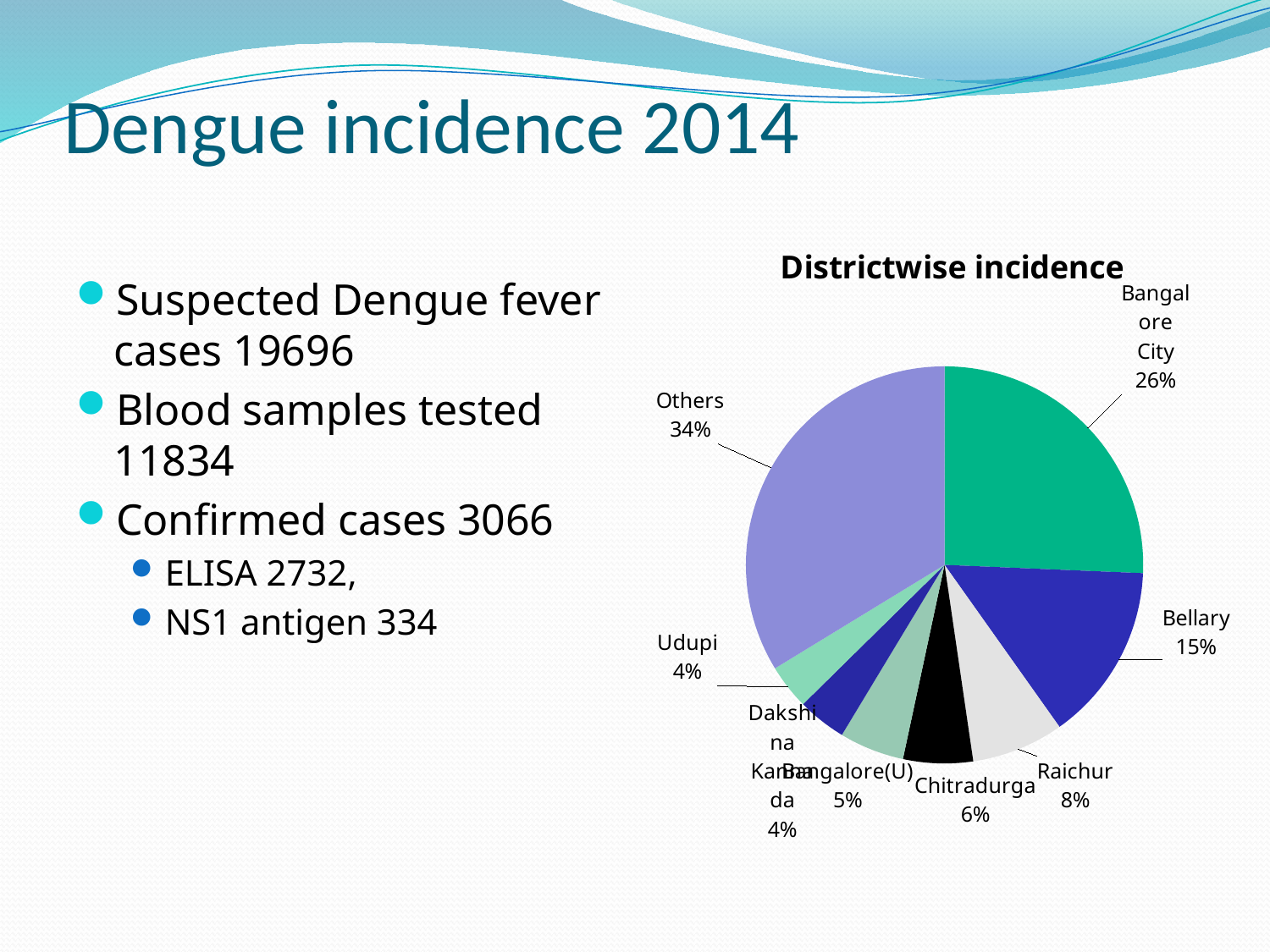
What percentage is shown for Udupi? 4% How many slices does the pie chart have? 8 What kind of chart is shown on the slide? pie chart What percentage is shown for Raichur? 8% What is the title of the chart? Districtwise incidence Which has the larger share, Raichur or Chitradurga? Raichur What share of the pie does Bangalore City account for? 26% Which slice of the pie is the largest? Others What percentage is shown for Chitradurga? 6% What percentage is shown for Bellary? 15% What is the difference in percentage points between Bangalore City and Bellary? 11 percentage points What percentage is shown for Bangalore(U)? 5%